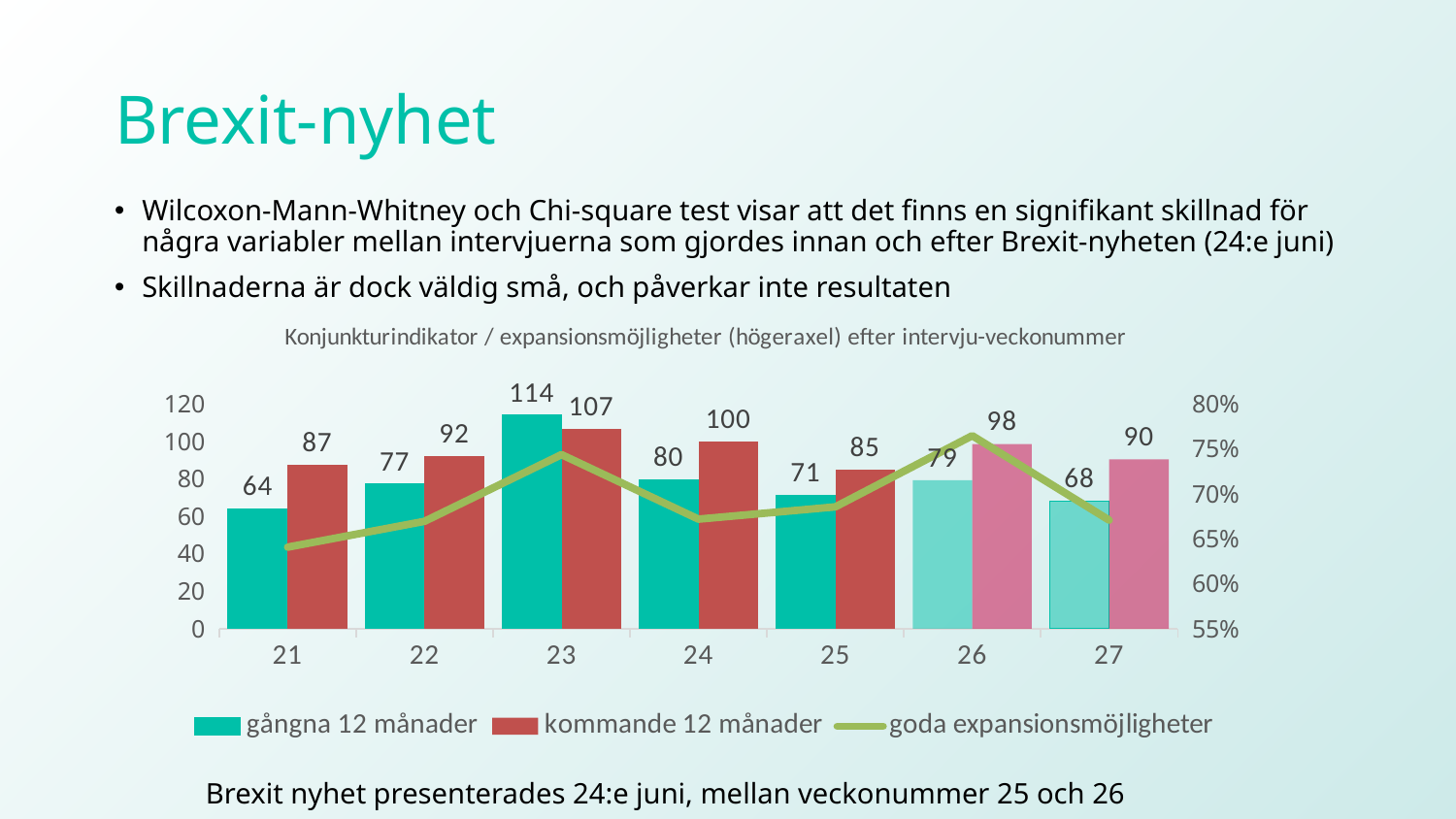
What is the value for 'kommande 12 månader' in week 26? 98 Which week has the highest value for 'kommande 12 månader'? 23 What is the title of the chart? Konjunkturindikator / expansionsmöjligheter (högeraxel) efter intervju-veckonummer In week 24, which is larger: 'gångna 12 månader' or 'kommande 12 månader'? kommande 12 månader What is the value for 'gångna 12 månader' in week 23? 114 How many series does the legend list? 3 Is the value of 'goda expansionsmöjligheter' in week 21 greater or less than 70%? less Is the value of 'goda expansionsmöjligheter' in week 26 greater or less than 75%? greater How many weeks are shown on the x axis? 7 What is the difference between 'kommande 12 månader' and 'gångna 12 månader' in week 27? 22 What is the value for 'gångna 12 månader' in week 21? 64 Which week has the lowest value for 'gångna 12 månader'? 21